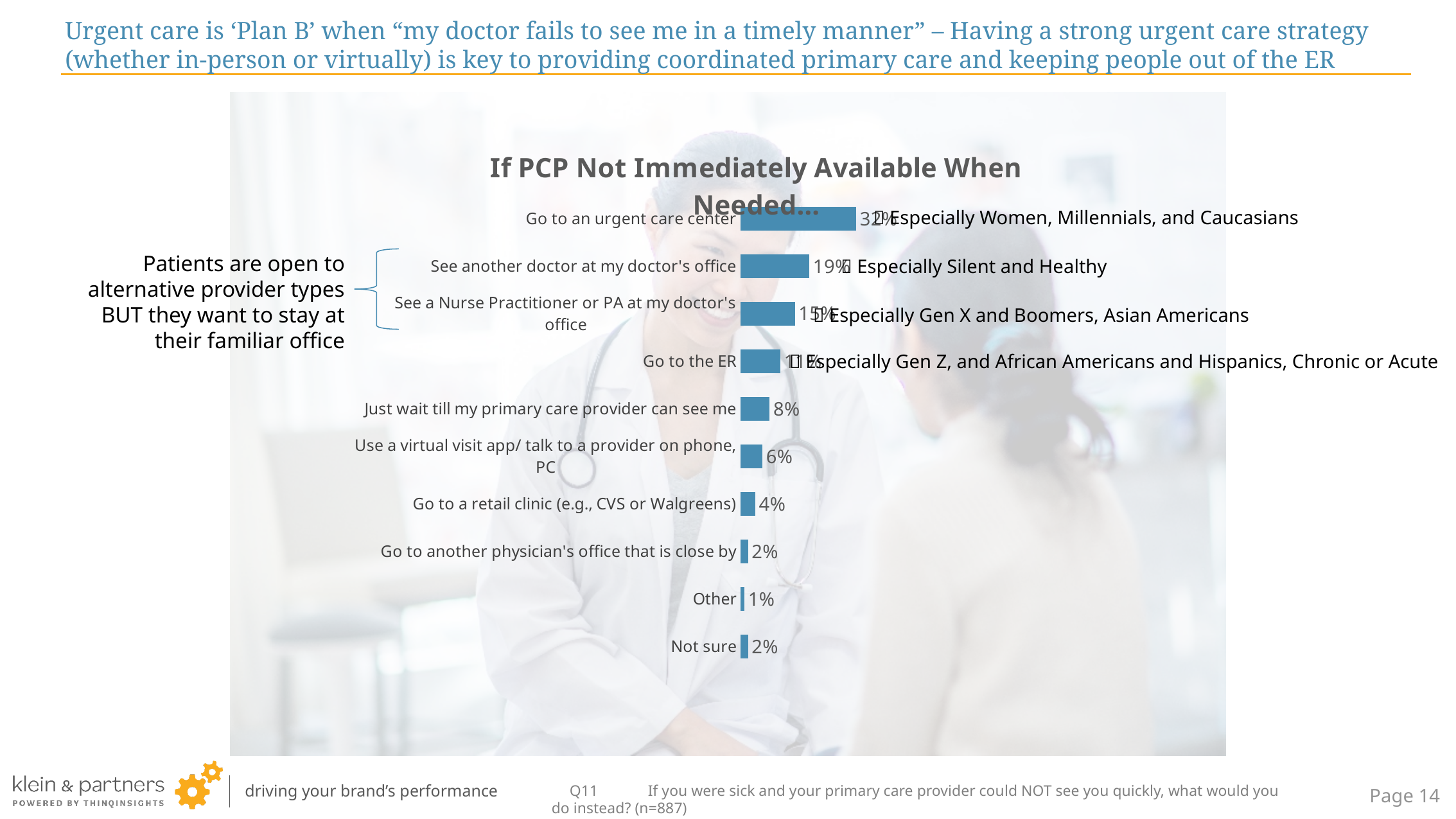
What is the value for 'Not sure'? 2% What is the value for 'Use a virtual visit app/ talk to a provider on phone, PC'? 6% What is the difference between 'See another doctor at my doctor's office' and 'Just wait till my primary care provider can see me'? 11 percentage points What percentage of respondents would see another doctor at their doctor's office? 19% Which option has the highest percentage? Go to an urgent care center What is the value for 'Go to a retail clinic (e.g., CVS or Walgreens)'? 4% How many categories are plotted in the chart? 10 What is the title of the chart? If PCP Not Immediately Available When Needed… What is the value for 'Other'? 1% What percentage would just wait till their primary care provider can see them? 8% Which option has the lowest percentage? Other What kind of chart is shown on the slide? bar chart